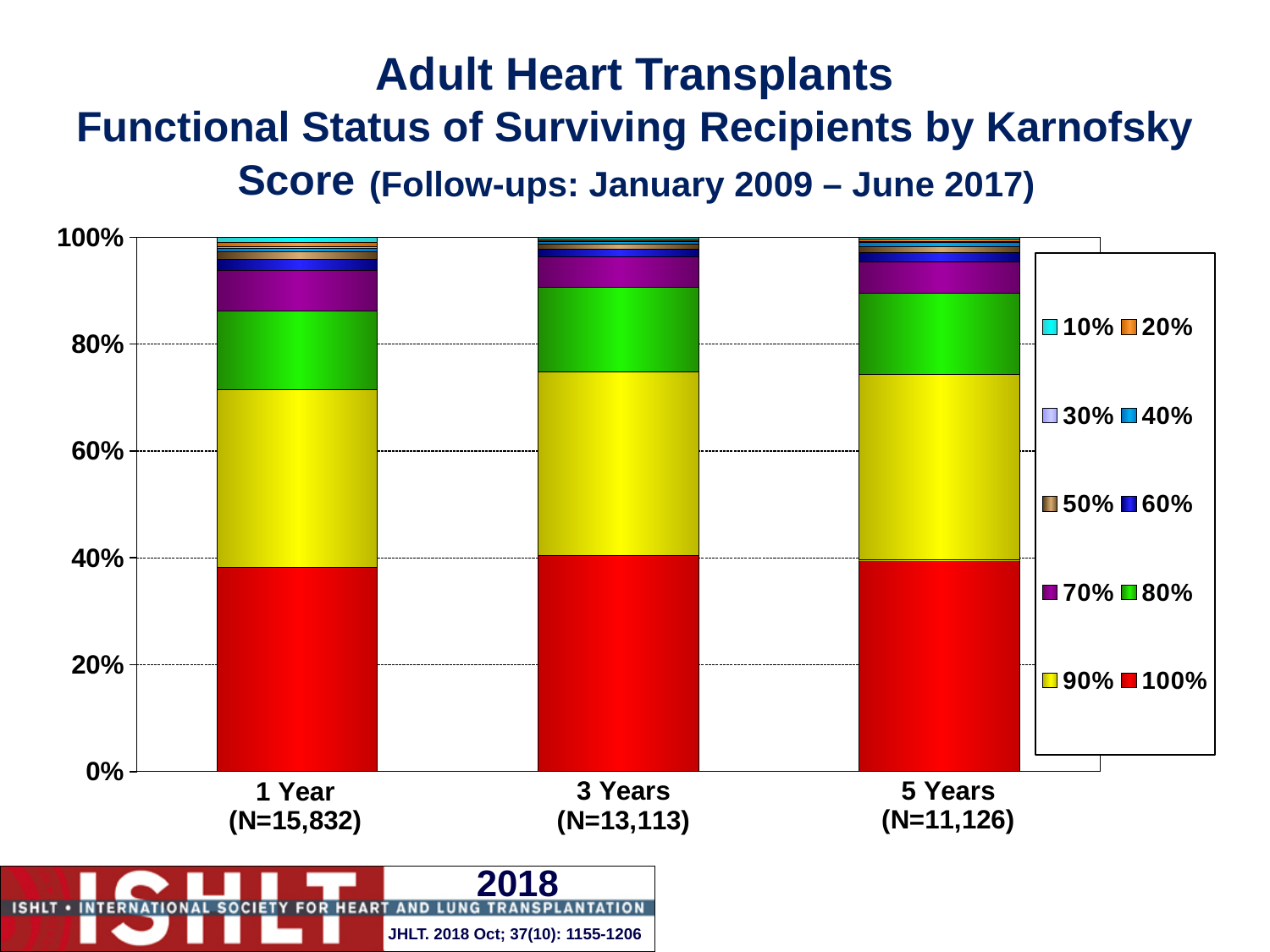
In the 3 Years bar, which segment is larger: the 100% Karnofsky score segment or the 90% segment? 100% What colour represents the 100% Karnofsky score in the legend? Red What kind of chart is shown on the slide? Stacked bar chart What follow-up period is given in the chart title? January 2009 – June 2017 Is the share of the 100% Karnofsky score segment in the 1 Year bar greater or less than 40%? less What is the total height of each stacked bar on the y axis? 100% How many follow-up time points (categories) are shown on the x axis? 3 In the 1 Year bar, which segment is larger: the 80% Karnofsky score segment or the 70% segment? 80% What is the N shown for the 3 Years category? N=13,113 How many Karnofsky score series does the legend list? 10 What is the N shown for the 1 Year category? N=15,832 What is the N shown for the 5 Years category? N=11,126